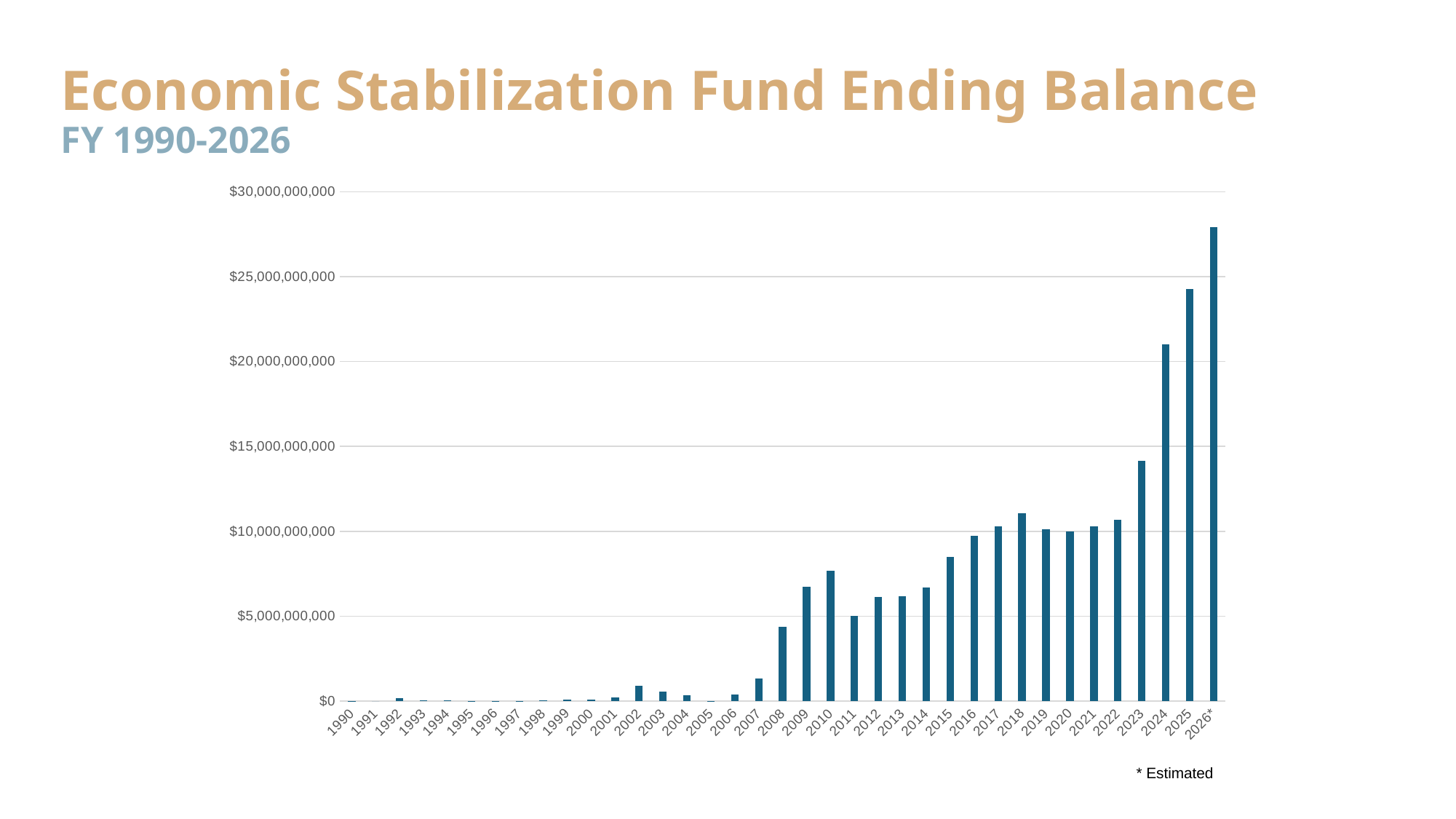
What kind of chart is shown on the slide? Bar chart Overall, do the ending balances rise or fall from 1990 to 2026? Rise Is the value for 2025 greater or less than $25,000,000,000? less Is the value for 2023 greater or less than $15,000,000,000? less Is the value for 2008 greater or less than $5,000,000,000? less Which is larger, the ending balance for 2018 or for 2019? 2018 What is the title of the chart? Economic Stabilization Fund Ending Balance FY 1990-2026 How many fiscal years are plotted on the x axis? 37 Which fiscal year has the highest ending balance? 2026*